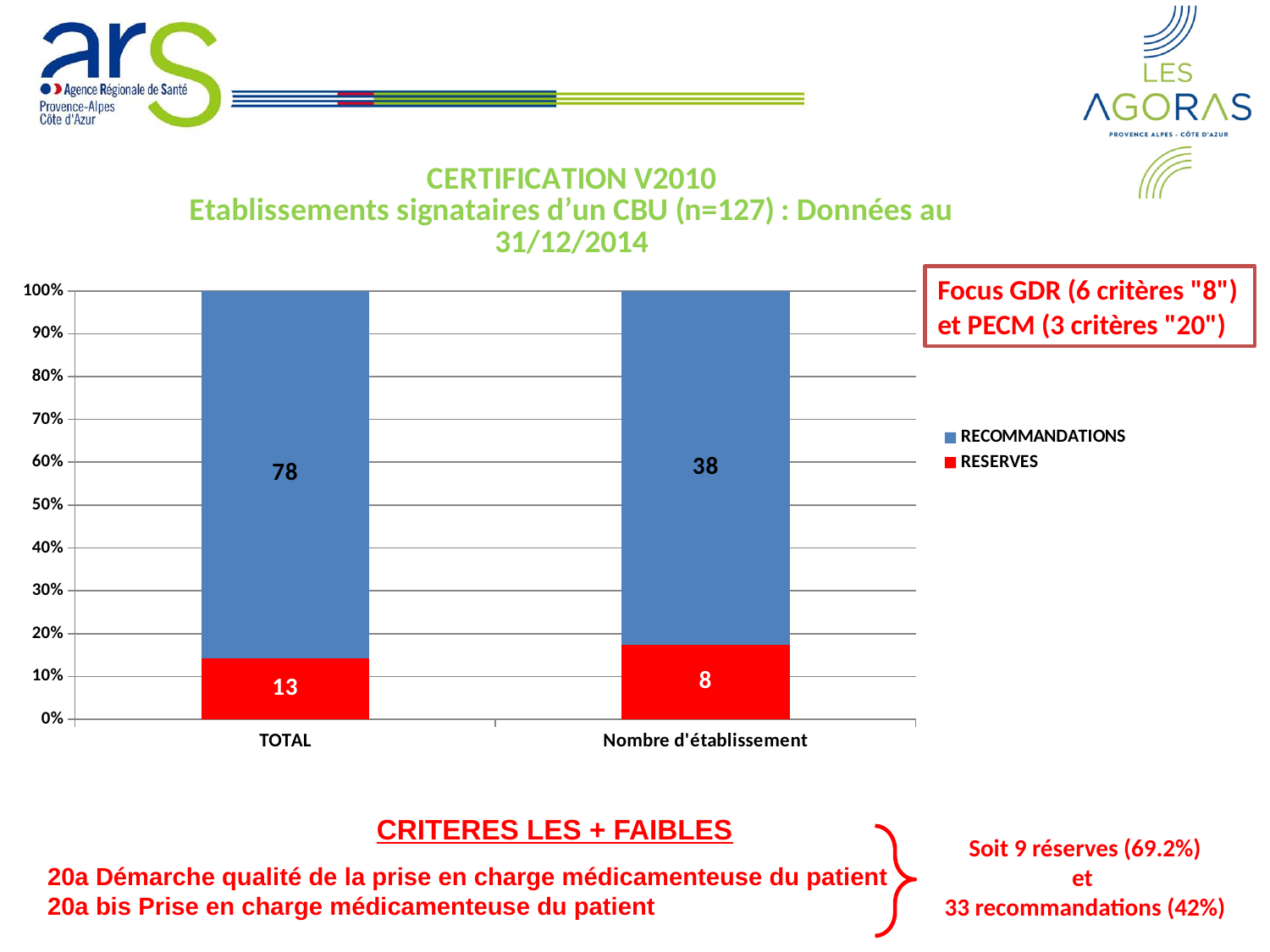
What is the value of RECOMMANDATIONS for the TOTAL bar? 78 What is the sum of the two labelled values in the TOTAL bar? 91 How many series does the chart legend list? 2 What is the value of RESERVES for the Nombre d'établissement bar? 8 How many categories are shown on the x axis of the chart? 2 What is the difference between the RECOMMANDATIONS values for TOTAL and Nombre d'établissement? 40 What is the value of RECOMMANDATIONS for the Nombre d'établissement bar? 38 Which category has the higher RESERVES value, TOTAL or Nombre d'établissement? TOTAL What is the value of RESERVES for the TOTAL bar? 13 What type of chart is shown on the slide? Stacked bar chart What is the difference between the RESERVES values for TOTAL and Nombre d'établissement? 5 What is the sum of the two labelled values in the Nombre d'établissement bar? 46